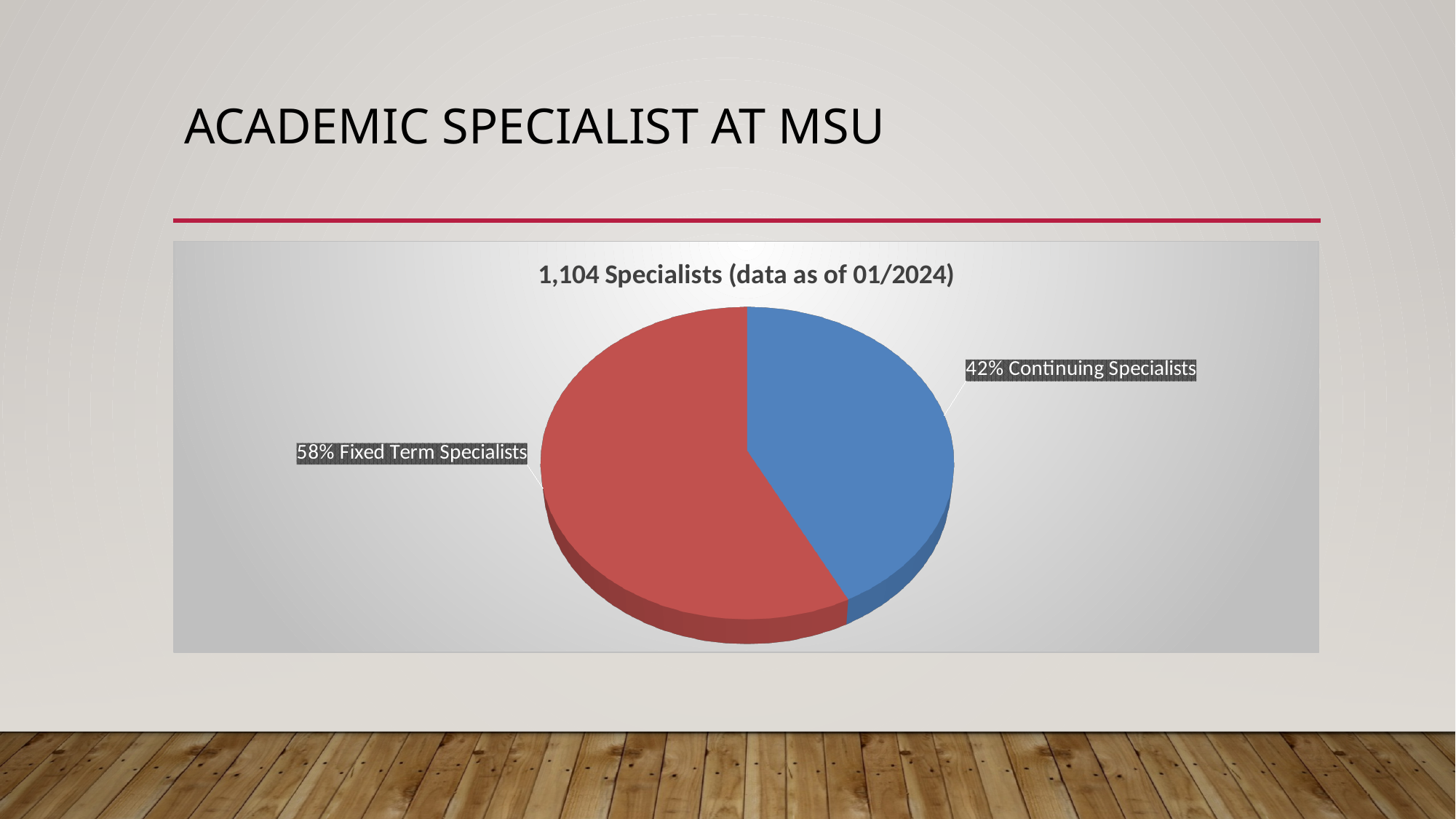
How many slices does the pie chart have? 2 What share of the pie is Continuing Specialists? 42% What colour is the Fixed Term Specialists slice? red What kind of chart is shown on the slide? pie chart What share of the pie is Fixed Term Specialists? 58% Is the share for Continuing Specialists greater or less than 50%? less Which slice of the pie is the largest? Fixed Term Specialists Which is larger, the Fixed Term Specialists slice or the Continuing Specialists slice? Fixed Term Specialists What is the title of the chart? 1,104 Specialists (data as of 01/2024) Which slice of the pie is the smallest? Continuing Specialists What is the difference in percentage points between the Fixed Term Specialists and Continuing Specialists slices? 16